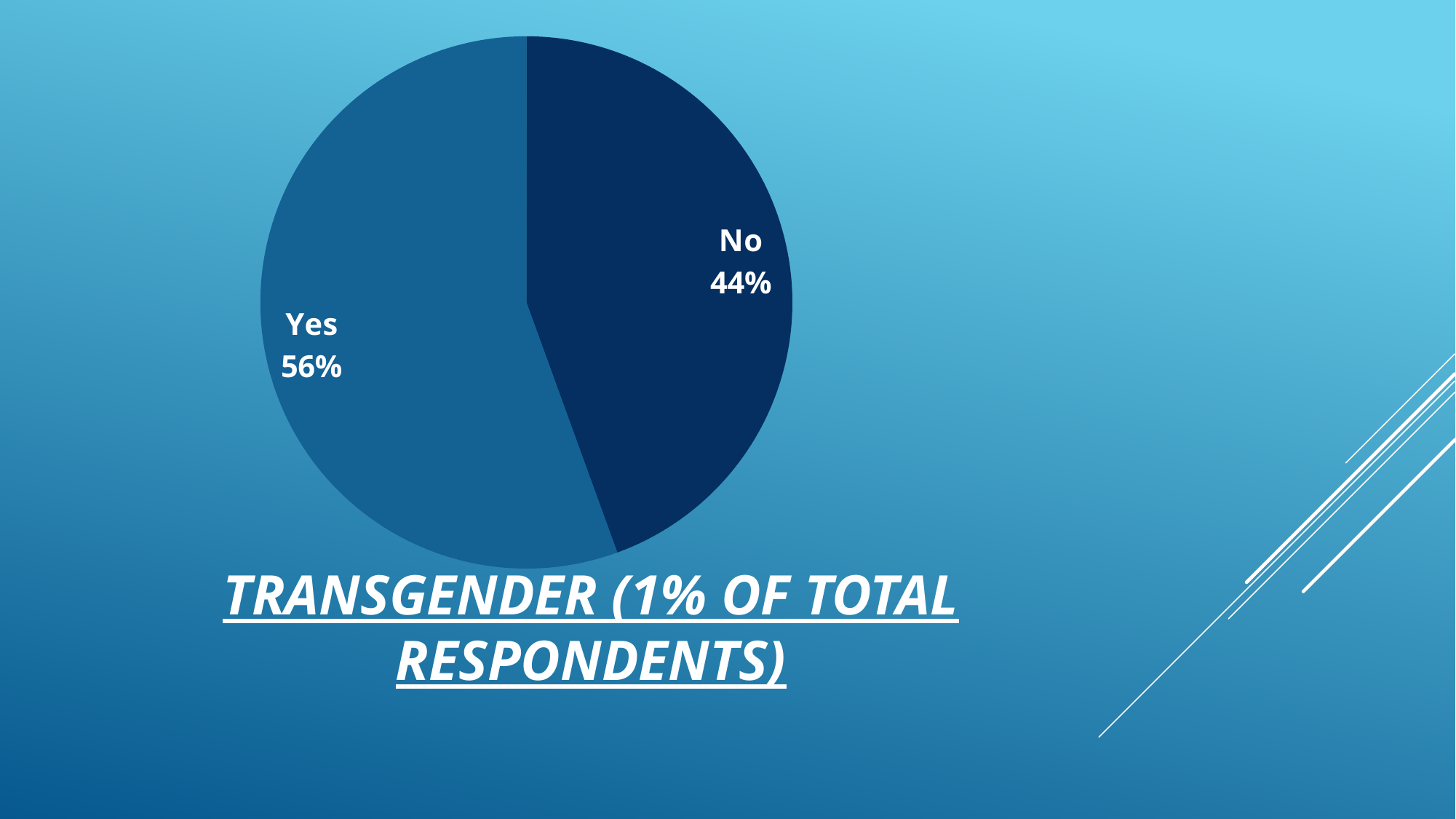
How many slices does the pie chart have? 2 What share of the pie does the No slice represent? 44% Which is larger, the Yes slice or the No slice? Yes Which slice is the smallest? No What is the title shown below the pie chart? TRANSGENDER (1% OF TOTAL RESPONDENTS) Which slice is the largest? Yes What is the difference in percentage points between the Yes and No slices? 12% What percentage of the pie is labelled Yes? 56% What percentage of the pie is labelled No? 44% What kind of chart is shown on the slide? pie chart Which slice is drawn in the darker blue colour? No